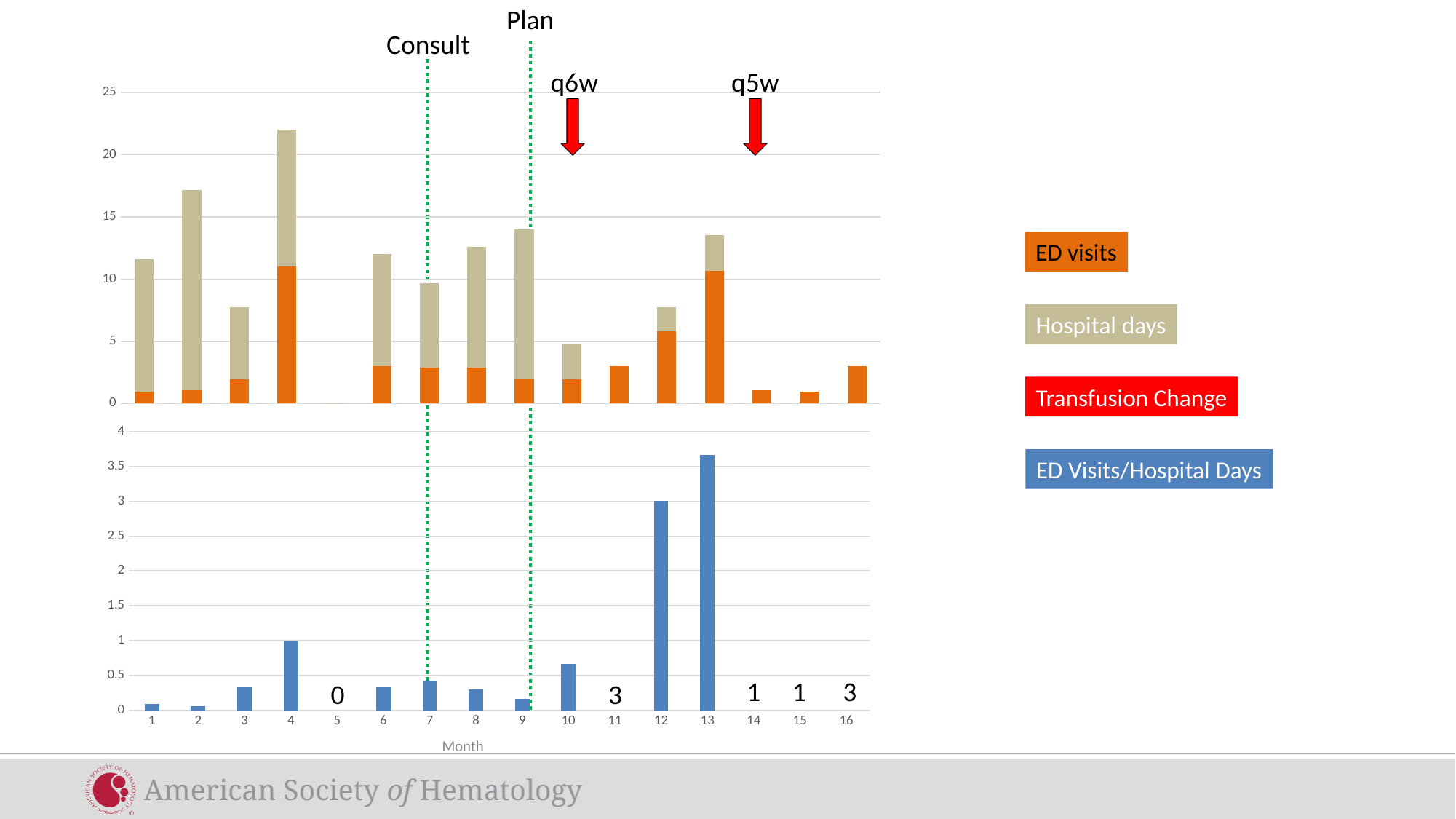
In the bottom chart (ED Visits/Hospital Days), what is the value for month 5? 0 In the top chart, which has the larger total stacked bar: month 12 or month 13? Month 13 In the top chart, is the total stacked value for month 4 greater or less than 20? greater In the bottom chart (ED Visits/Hospital Days), what is the value for month 11? 3 In the bottom chart (ED Visits/Hospital Days), is the value for month 13 greater or less than 3.5? greater In the bottom chart (ED Visits/Hospital Days), what is the value for month 16? 3 What label is shown on the x axis of the charts? Month In the bottom chart (ED Visits/Hospital Days), which month has the highest value? Month 13 What kind of chart is the top chart on the slide? bar chart In the top chart, which month has the tallest stacked bar? Month 4 In the bottom chart (ED Visits/Hospital Days), what is the value for month 12? 3 How many months are shown on the x axis of the charts? 16